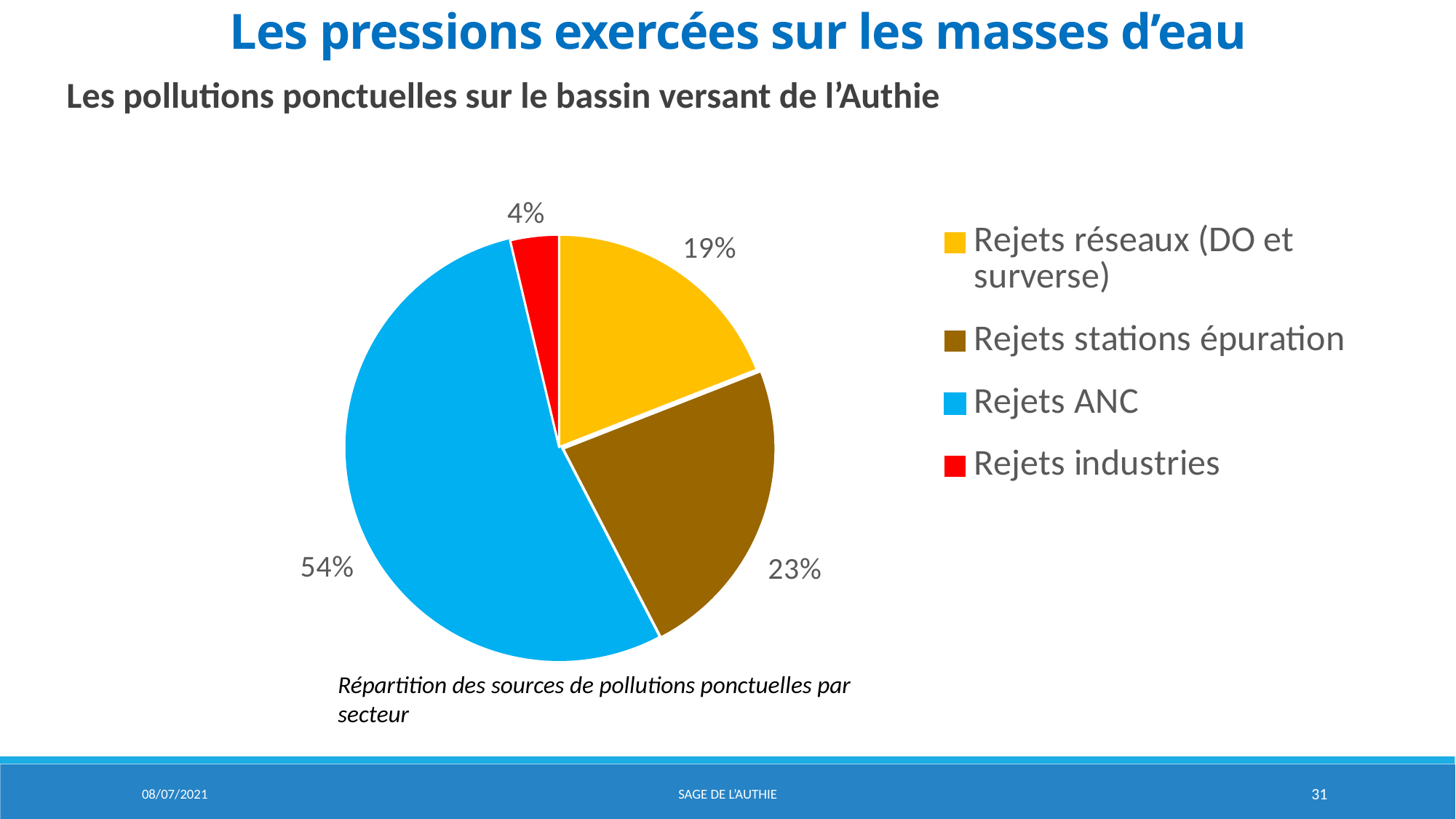
What share of the pie does Rejets réseaux (DO et surverse) represent? 19% How many categories does the pie chart have? 4 What share of the pie does Rejets ANC represent? 54% Which category has the smallest slice of the pie? Rejets industries Which category has the largest slice of the pie? Rejets ANC What kind of chart is shown on the slide? pie chart Which is larger, the share for Rejets stations épuration or the share for Rejets réseaux (DO et surverse)? Rejets stations épuration What is the difference in percentage points between Rejets ANC and Rejets stations épuration? 31 What share of the pie does Rejets stations épuration represent? 23% What colour is the slice for Rejets ANC? blue What is the caption below the pie chart? Répartition des sources de pollutions ponctuelles par secteur